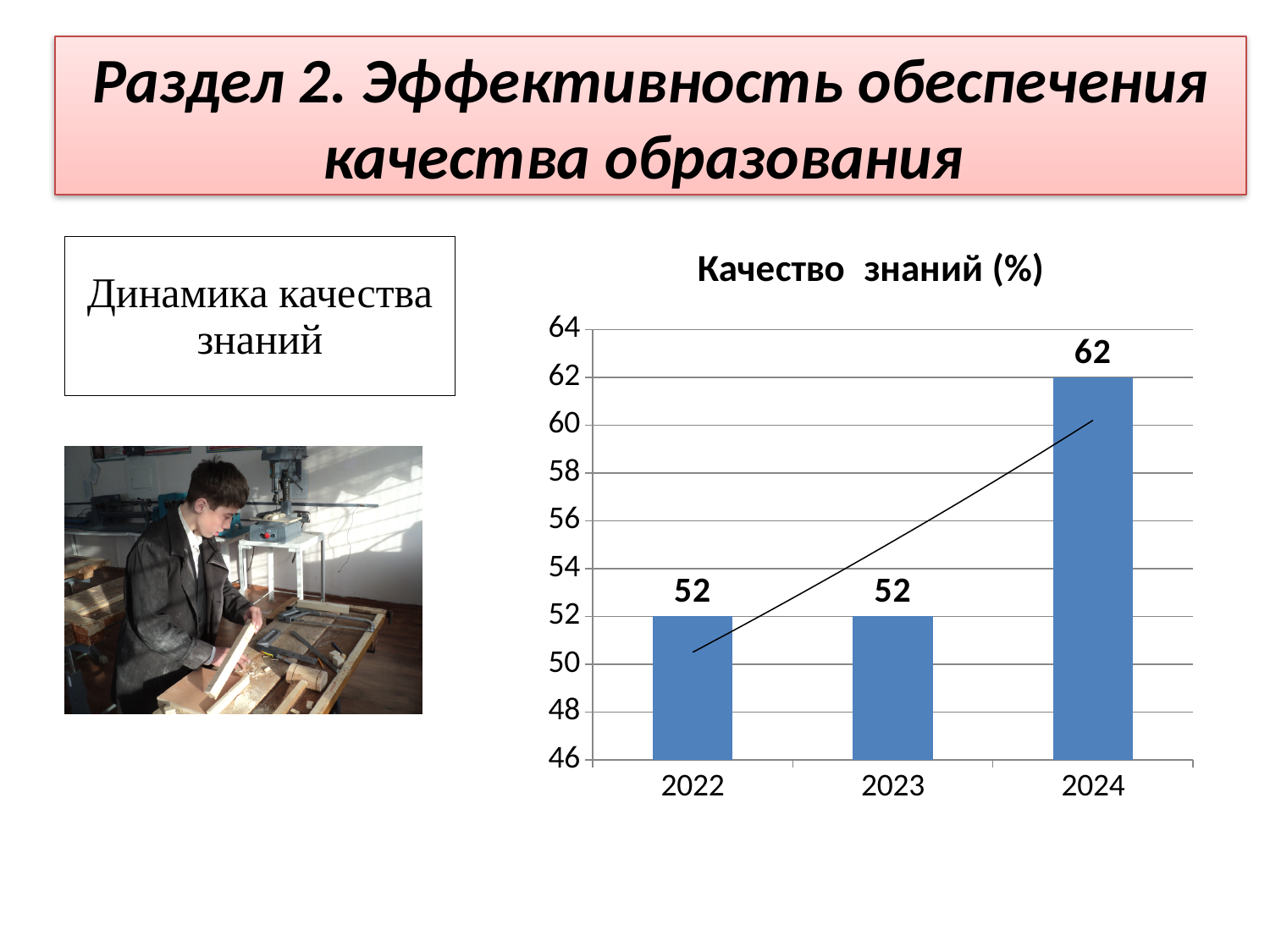
Do the values rise or fall from 2022 to 2024? rise What kind of chart is shown? bar chart What is the value for 2022? 52 How many years are shown on the x axis? 3 Which is larger, the value for 2022 or the value for 2024? 2024 Is the value for 2023 greater or less than 54? less What is the title of the chart? Качество знаний (%) What is the value for 2023? 52 What is the difference between the values for 2024 and 2023? 10 Is the value for 2024 greater or less than 60? greater Which year has the highest value? 2024 What is the value for 2024? 62